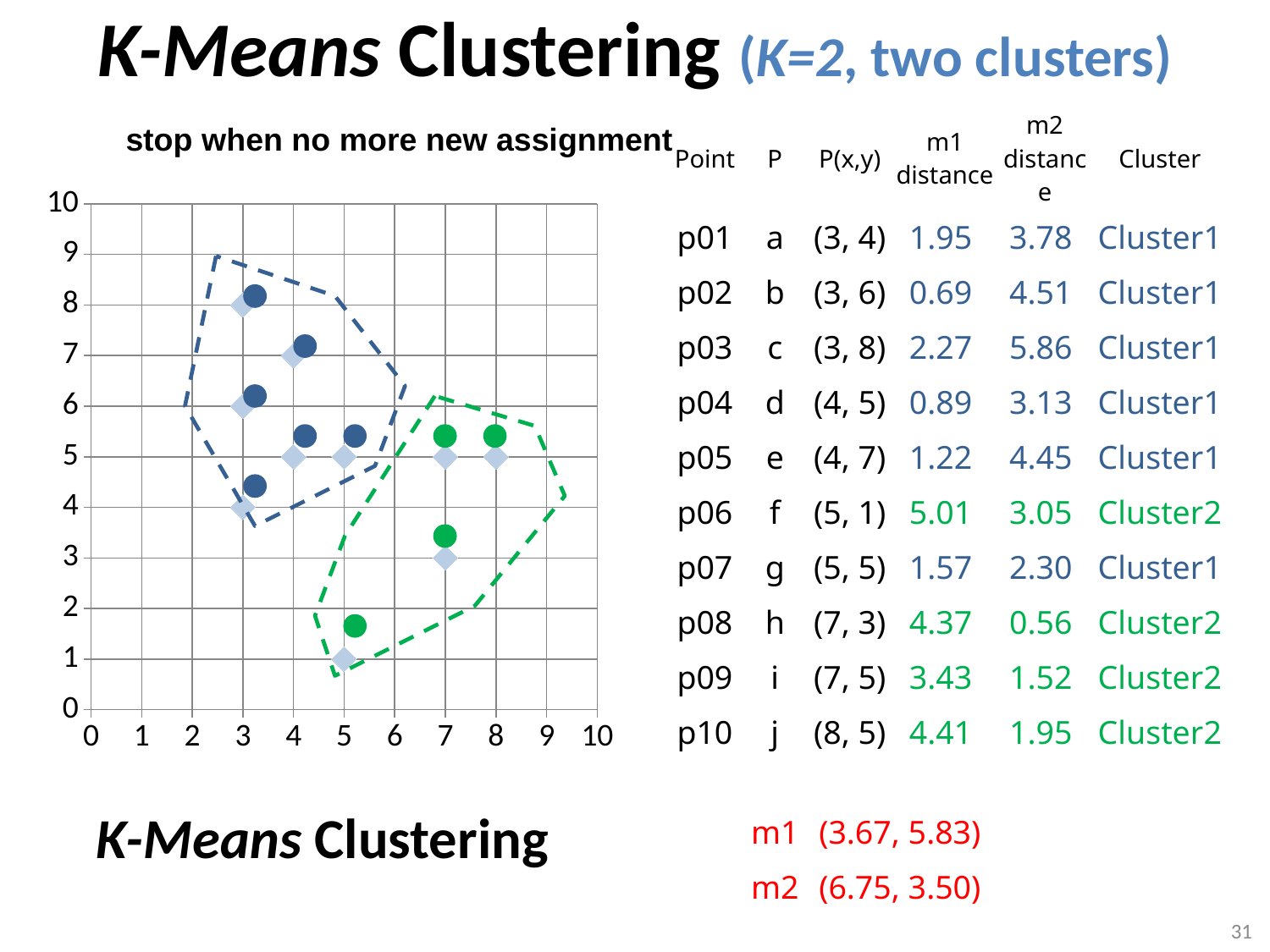
How many green (Cluster2) points are plotted in the scatter chart? 4 What text appears above the scatter chart as its heading? stop when no more new assignment Which point has the larger y value in the scatter chart, b or d? b Is the x value of point j in the scatter chart greater or less than 7? greater What is the maximum value shown on the x axis of the scatter chart? 10 Which point in the scatter chart has the highest y value? c Which point in the scatter chart has the lowest y value? f Which point in the scatter chart has the largest x value? j What are the coordinates of point c in the scatter chart? (3, 8) How many data points are plotted in the scatter chart? 10 How many blue (Cluster1) points are plotted in the scatter chart? 6 What kind of chart is shown on the left of the slide? scatter chart